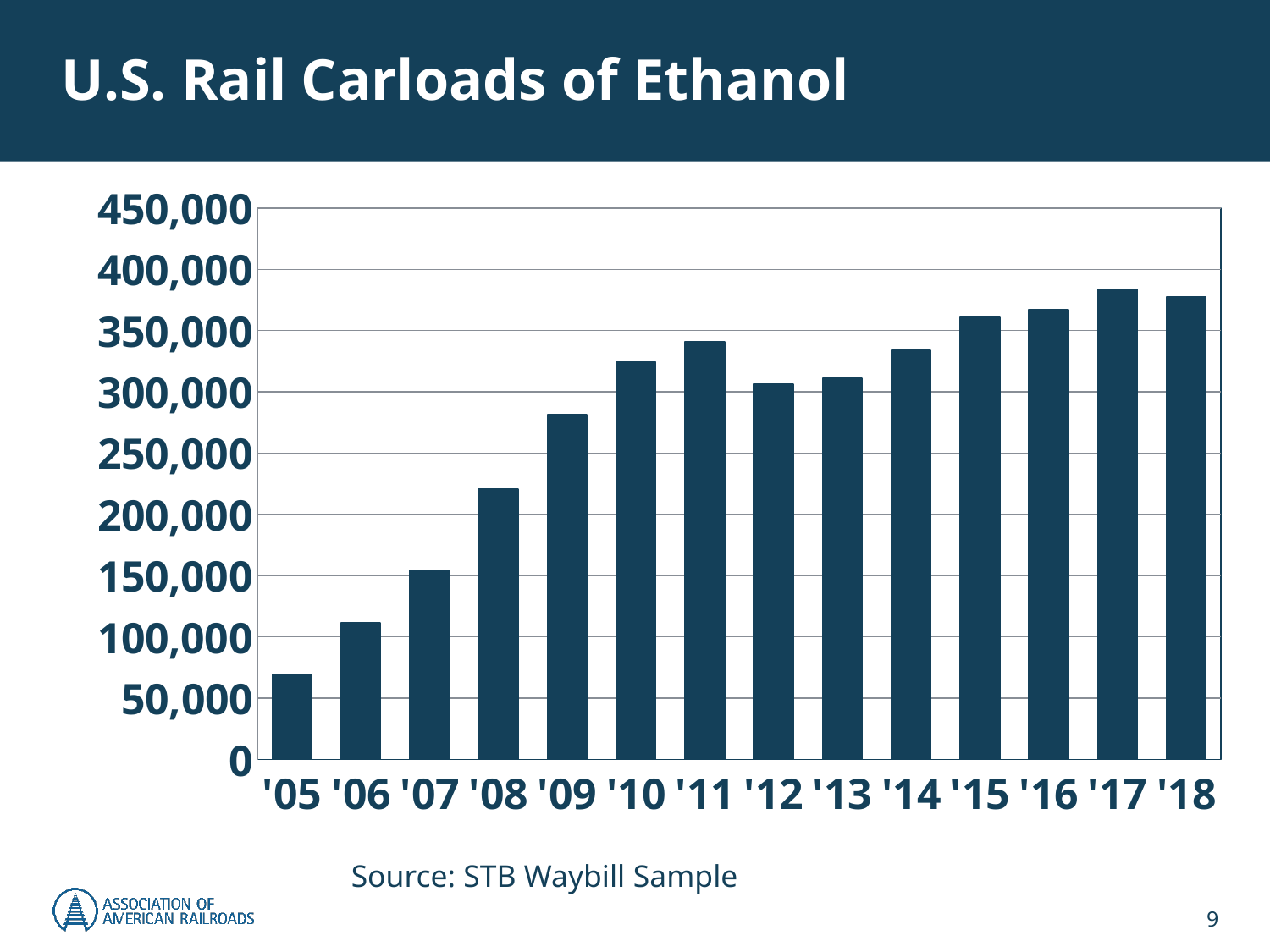
What kind of chart is shown on the slide? bar chart What is the source cited for the chart data? STB Waybill Sample Do rail carloads of ethanol generally rise or fall from '05 to '18? rise Which year has more rail carloads of ethanol, '11 or '12? '11 How many years are plotted on the chart? 14 Is the value for '08 greater or less than 200,000? greater Which year has the lowest number of rail carloads of ethanol? '05 Which year has the highest number of rail carloads of ethanol? '17 Is the value for '17 greater or less than 400,000? less Is the value for '15 greater or less than 350,000? greater